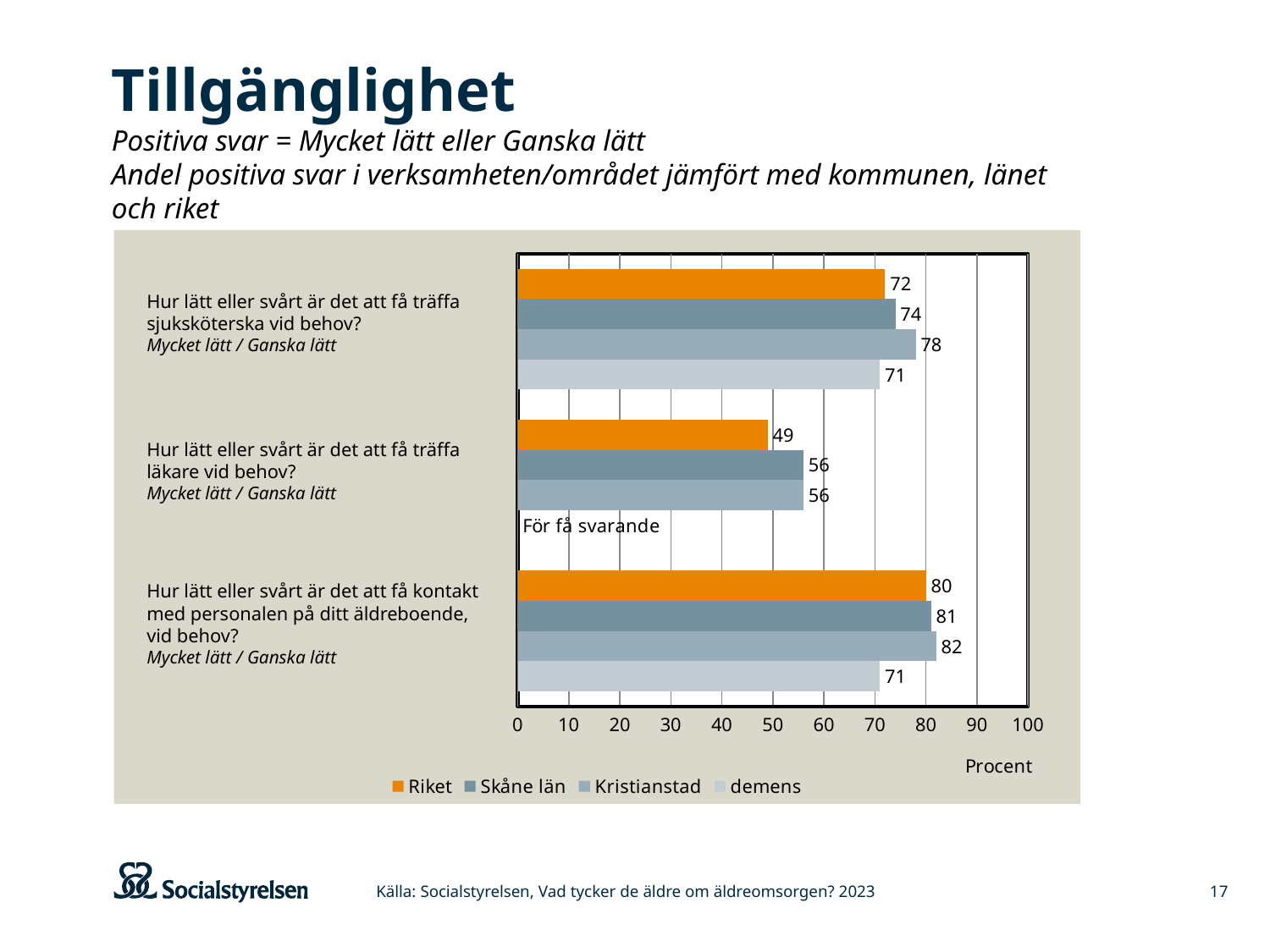
What kind of chart is shown on the slide? Bar chart Which series has the highest value on the question about getting in contact with staff at the care home? Kristianstad What text is shown instead of a bar for the demens series on the question about meeting a doctor (läkare)? För få svarande Which is larger on the question about meeting a doctor (läkare): the value for Riket or the value for Skåne län? Skåne län What is the difference between Kristianstad and Riket on the question about meeting a nurse (sjuksköterska) when needed? 6 How many series does the legend list? 4 Which series has the lowest value on the question about meeting a doctor (läkare) when needed, among those with a plotted bar? Riket What is the value for Riket on the question about meeting a doctor (läkare) when needed? 49 What is the value for Riket on the question about meeting a nurse (sjuksköterska) when needed? 72 What is the value for Kristianstad on the question about meeting a nurse (sjuksköterska) when needed? 78 What is the label of the x axis? Procent What is the value for demens on the question about getting in contact with staff at the care home? 71